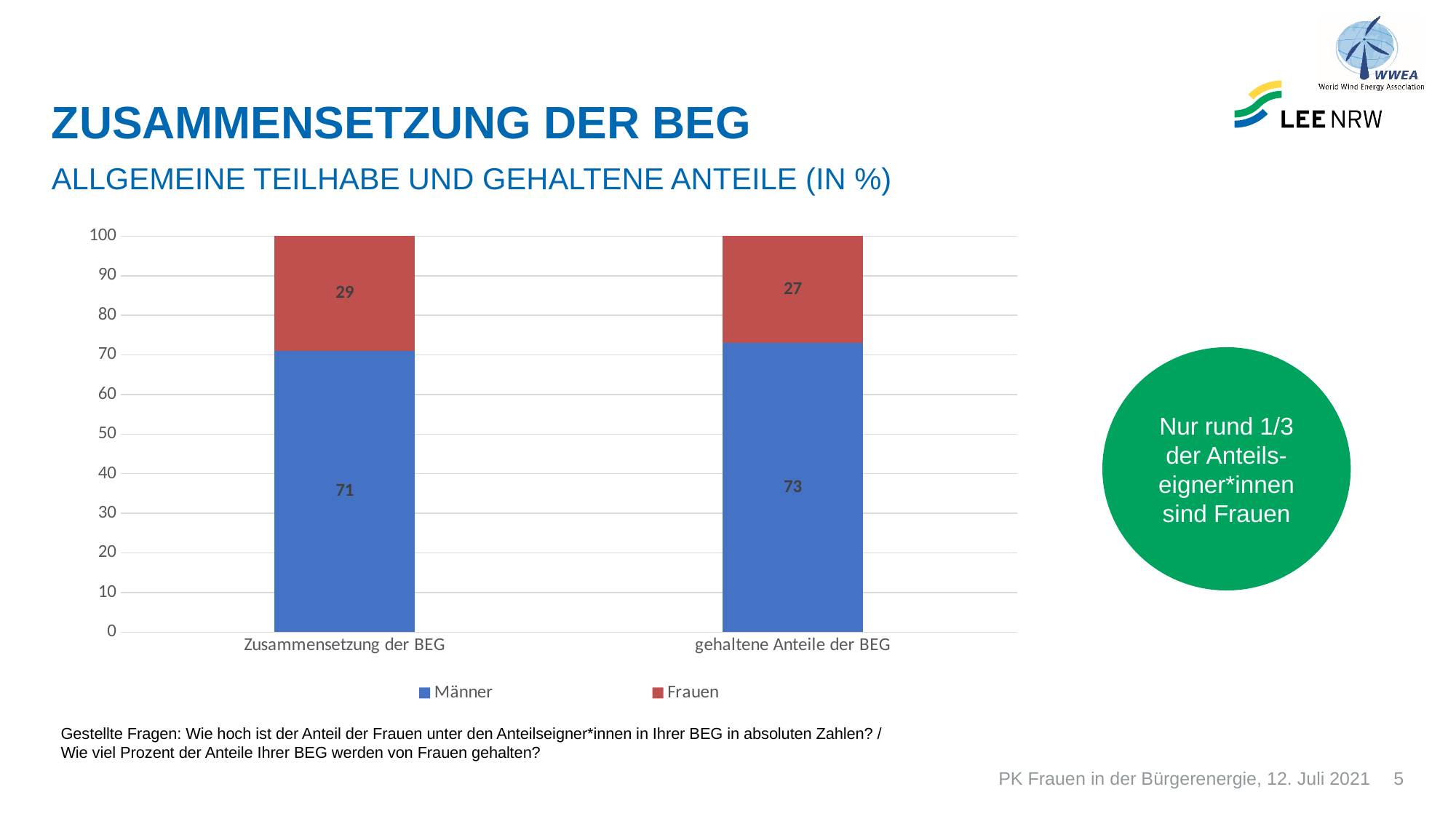
What kind of chart is shown on the slide? Stacked bar chart Which category has the higher Männer value, 'Zusammensetzung der BEG' or 'gehaltene Anteile der BEG'? gehaltene Anteile der BEG What is the difference between the Frauen values for 'Zusammensetzung der BEG' and 'gehaltene Anteile der BEG'? 2 What is the value for Frauen in the 'Zusammensetzung der BEG' bar? 29 What is the value for Männer in the 'gehaltene Anteile der BEG' bar? 73 What is the value for Frauen in the 'gehaltene Anteile der BEG' bar? 27 What is the total of the stacked bar for 'gehaltene Anteile der BEG'? 100 How many series does the legend list? 2 What is the difference between the Männer and Frauen values in the 'Zusammensetzung der BEG' bar? 42 What is the value for Männer in the 'Zusammensetzung der BEG' bar? 71 Which colour represents Frauen in the chart? Red How many categories are shown on the x axis? 2